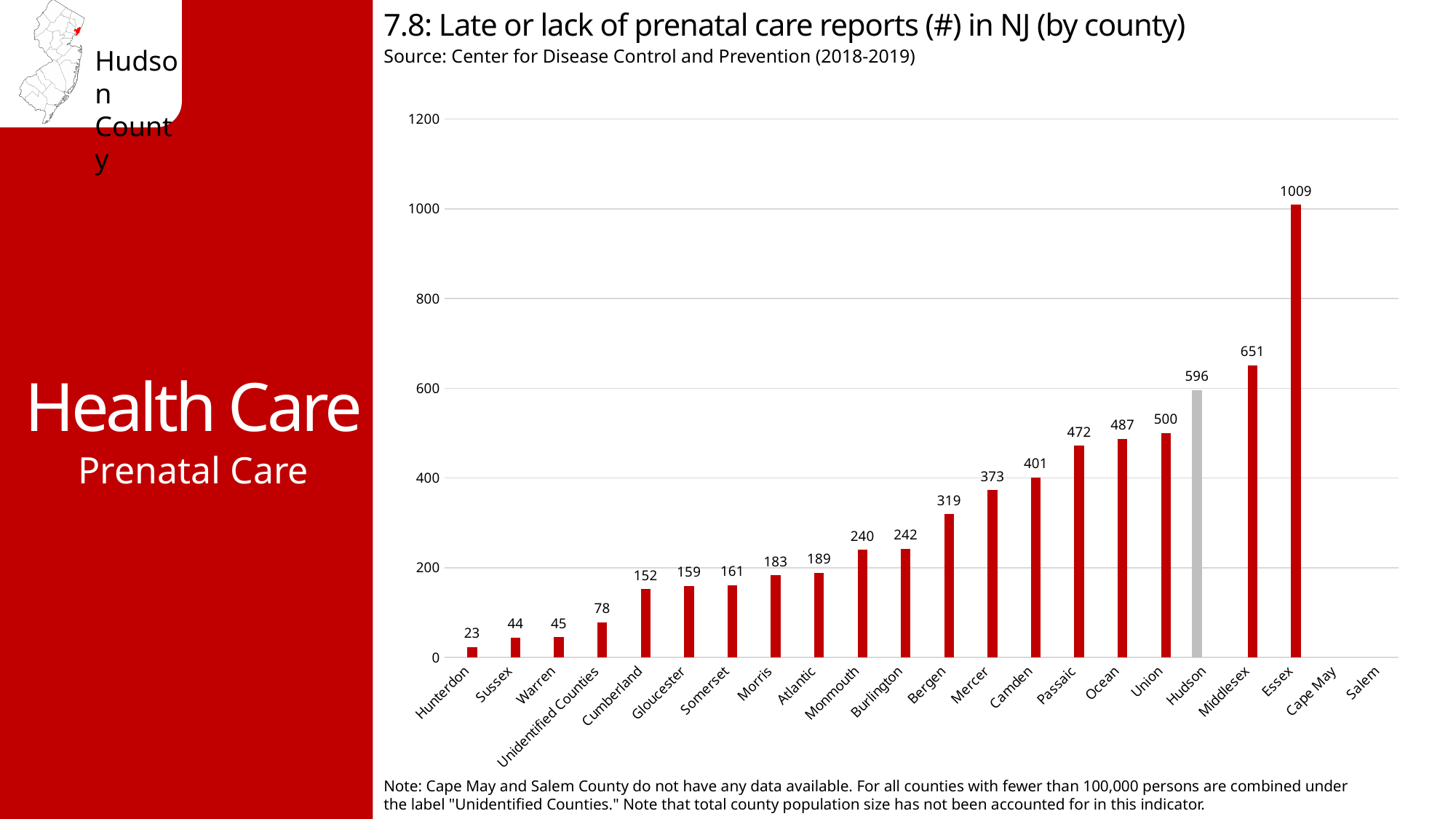
What type of chart is shown on the slide? Bar chart Which county with a plotted value has the lowest number of reports? Hunterdon Which bar is shown in grey rather than red? Hudson What is the difference between the values for Essex and Middlesex? 358 What is the number of late or lack of prenatal care reports for Hudson County? 596 What is the difference between the values for Hudson and Union? 96 How many counties are listed on the x axis, including Unidentified Counties? 22 Is the value for Middlesex greater or less than 600? greater Which has a larger value, Bergen or Mercer? Mercer Which county has the highest number of late or lack of prenatal care reports? Essex What is the value shown for Cumberland County? 152 What is the value shown for Essex County? 1009